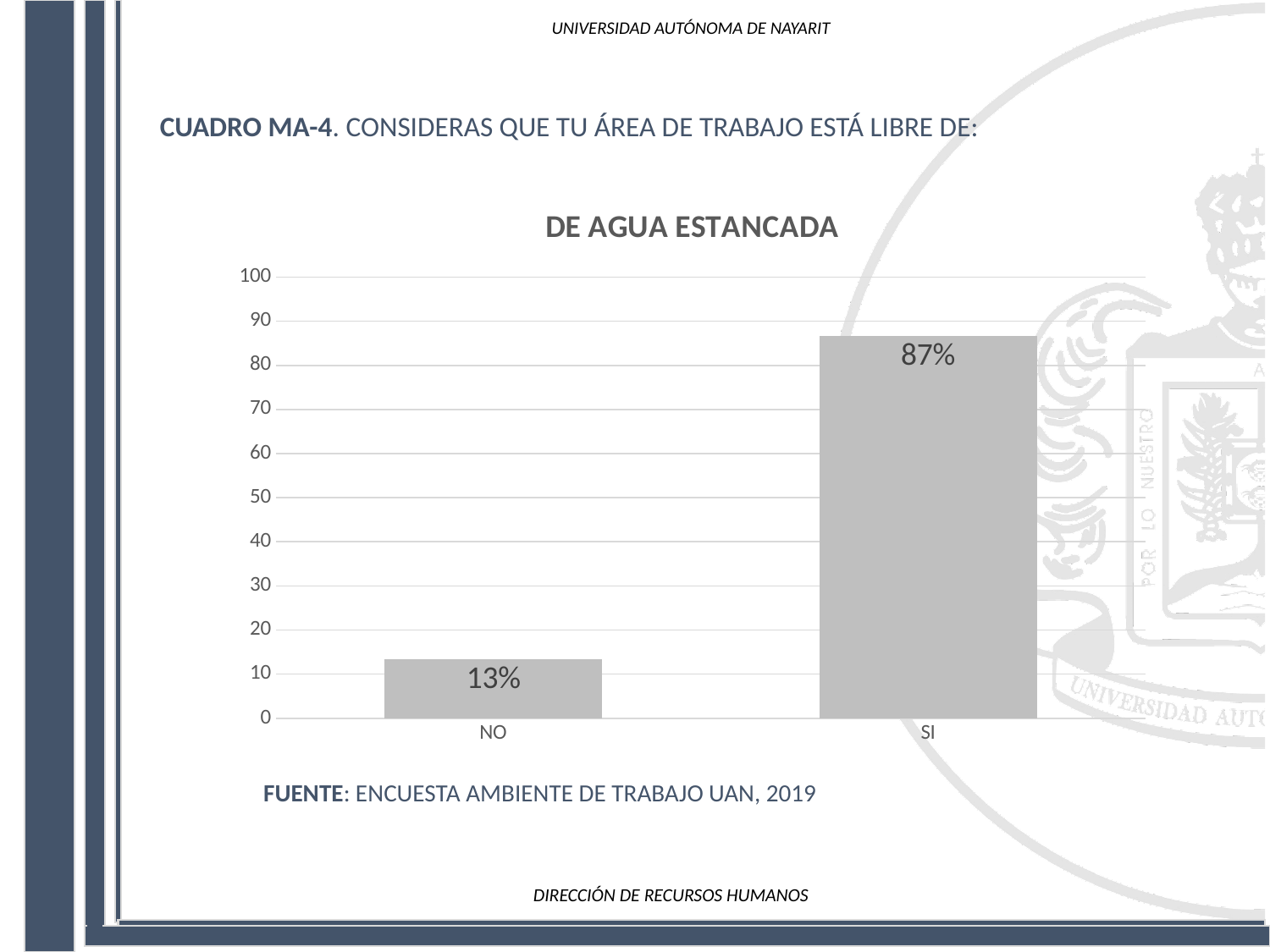
Which category has the highest value? SI What is the value for NO? 13% Is the value for NO greater or less than 20? less What is the title of the chart? DE AGUA ESTANCADA What kind of chart is shown? bar chart What is the value for SI? 87% What is the maximum value shown on the vertical axis? 100 What is the difference between the values for SI and NO? 74% Which category has the lowest value? NO Which is larger, the value for NO or the value for SI? SI Is the value for SI greater or less than 80? greater How many categories are shown on the x axis? 2